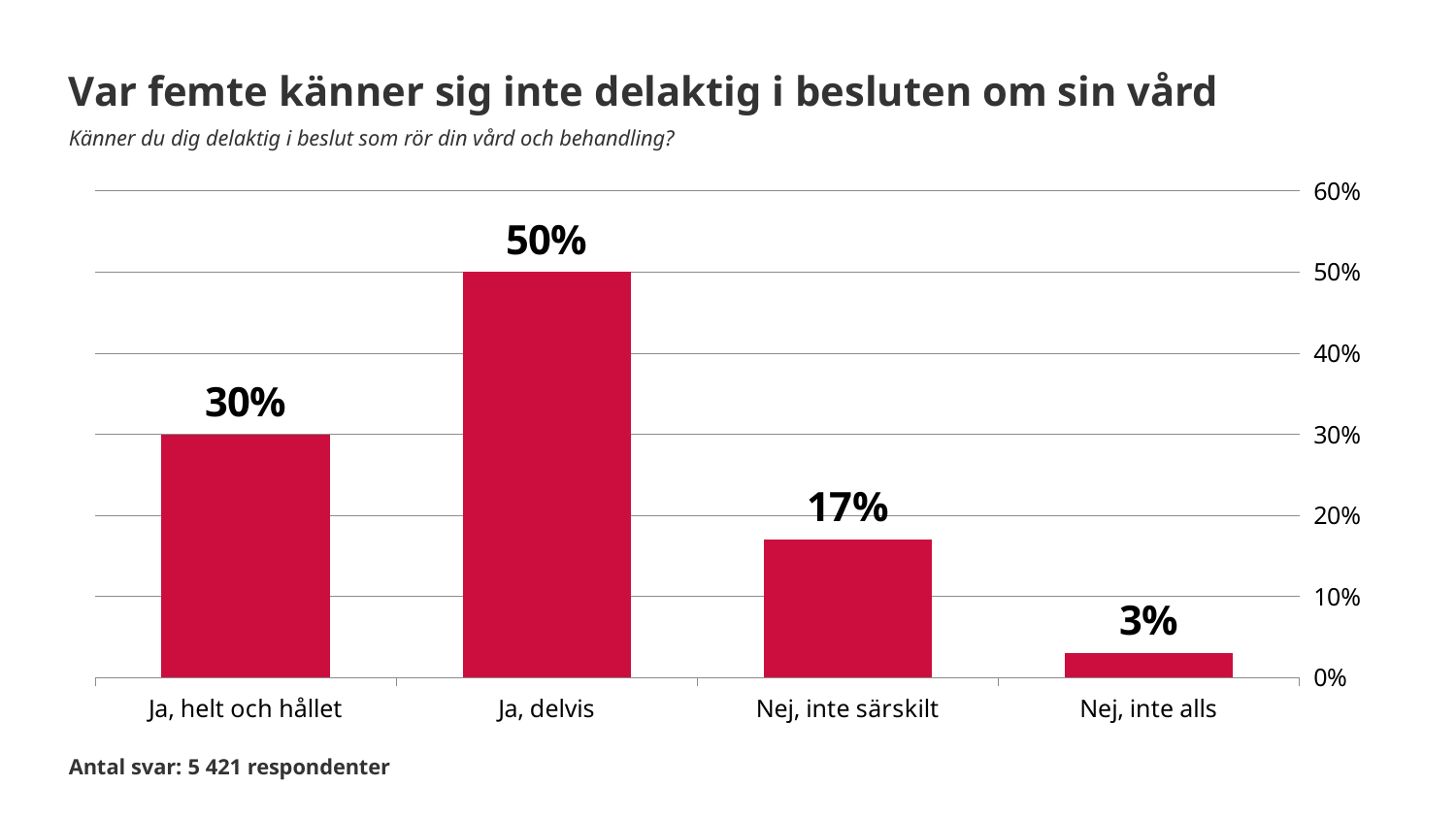
Which category has the lowest value? Nej, inte alls Is the value for "Nej, inte särskilt" greater or less than 20%? less How many categories are shown on the x axis? 4 What is the highest value shown on the y axis? 60% What is the value for "Ja, helt och hållet"? 30% What is the value for "Ja, delvis"? 50% Which category has the highest value? Ja, delvis What is the difference between the values for "Nej, inte särskilt" and "Nej, inte alls"? 14% What kind of chart is shown on the slide? Bar chart What is the difference between the values for "Ja, delvis" and "Ja, helt och hållet"? 20% Which is larger, the value for "Ja, helt och hållet" or the value for "Nej, inte särskilt"? Ja, helt och hållet What is the value for "Nej, inte alls"? 3%